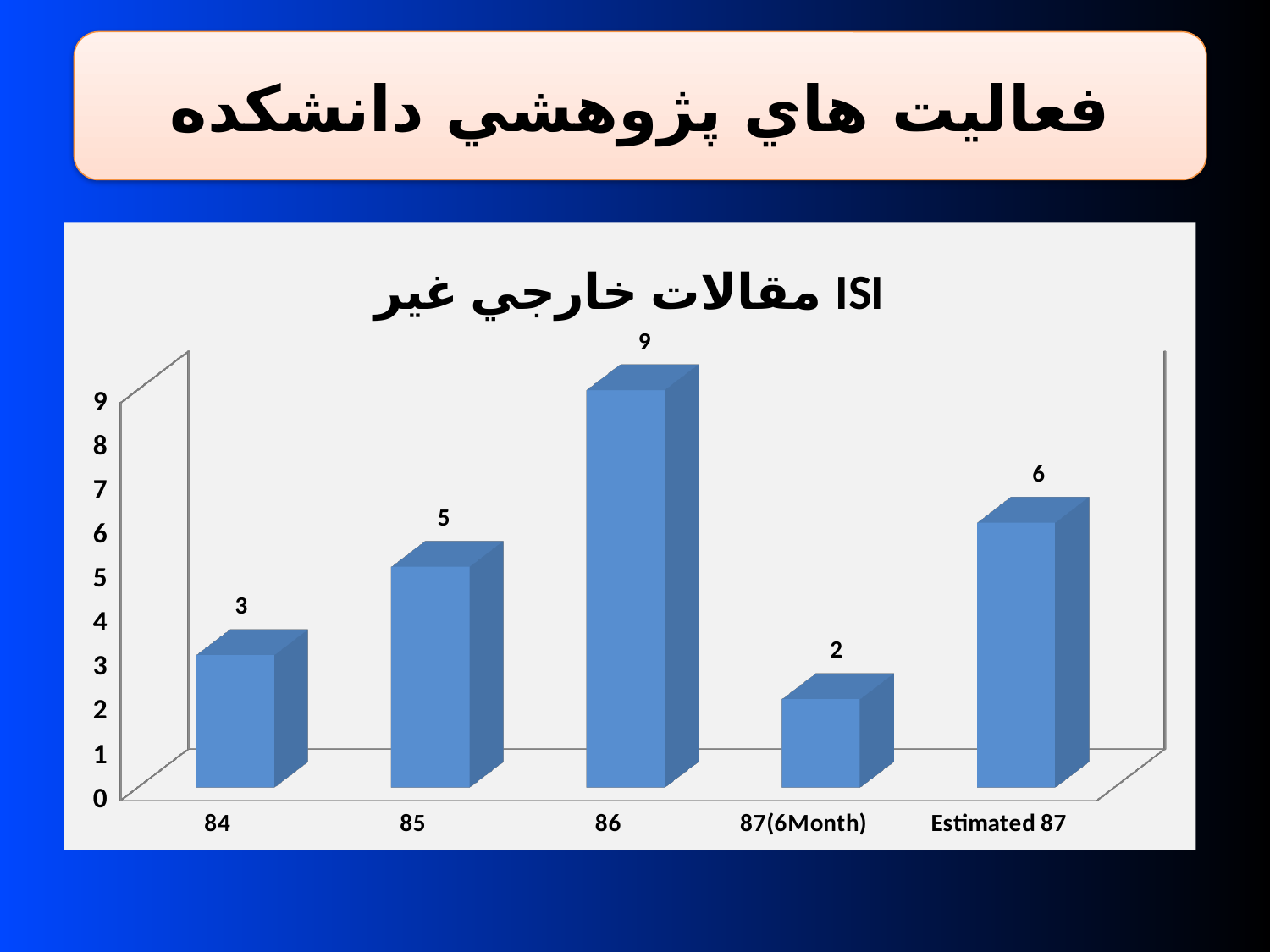
What is the value for 86? 9 What is the title of the chart? مقالات خارجي غير ISI What is the value for 87(6Month)? 2 What is the value for Estimated 87? 6 Which category has the lowest value? 87(6Month) Which is larger, the value for Estimated 87 or the value for 85? Estimated 87 What kind of chart is shown? bar chart How many categories are shown on the x axis? 5 What is the value for 85? 5 What is the value for 84? 3 Which category has the highest value? 86 What is the difference between the values for 86 and 85? 4